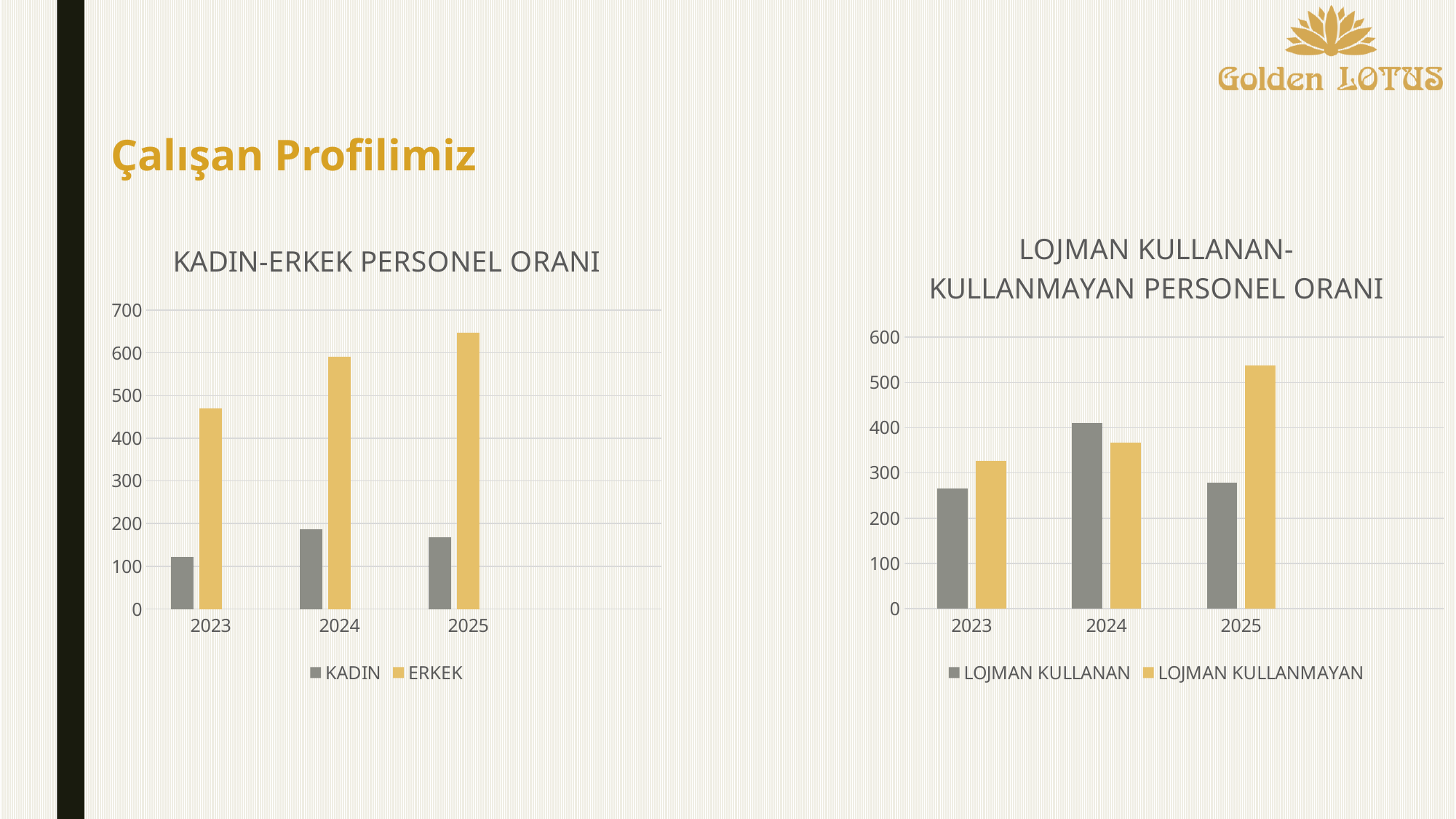
In the KADIN-ERKEK PERSONEL ORANI chart, does the ERKEK series rise or fall from 2023 to 2025? rise In the KADIN-ERKEK PERSONEL ORANI chart, is the ERKEK value for 2025 greater or less than 600? greater How many series does the legend of the KADIN-ERKEK PERSONEL ORANI chart list? 2 In the LOJMAN KULLANAN-KULLANMAYAN PERSONEL ORANI chart, which colour represents LOJMAN KULLANMAYAN? gold In the KADIN-ERKEK PERSONEL ORANI chart, which year has the highest ERKEK value? 2025 In the LOJMAN KULLANAN-KULLANMAYAN PERSONEL ORANI chart, which is larger for 2024: LOJMAN KULLANAN or LOJMAN KULLANMAYAN? LOJMAN KULLANAN In the LOJMAN KULLANAN-KULLANMAYAN PERSONEL ORANI chart, which year has the highest LOJMAN KULLANAN value? 2024 In the KADIN-ERKEK PERSONEL ORANI chart, which year has the lowest KADIN value? 2023 In the KADIN-ERKEK PERSONEL ORANI chart, is the KADIN value for 2024 greater or less than 200? less What kind of chart is the KADIN-ERKEK PERSONEL ORANI chart? bar chart How many years are shown on the x axis of the LOJMAN KULLANAN-KULLANMAYAN PERSONEL ORANI chart? 3 In the LOJMAN KULLANAN-KULLANMAYAN PERSONEL ORANI chart, is the LOJMAN KULLANMAYAN value for 2025 greater or less than 500? greater